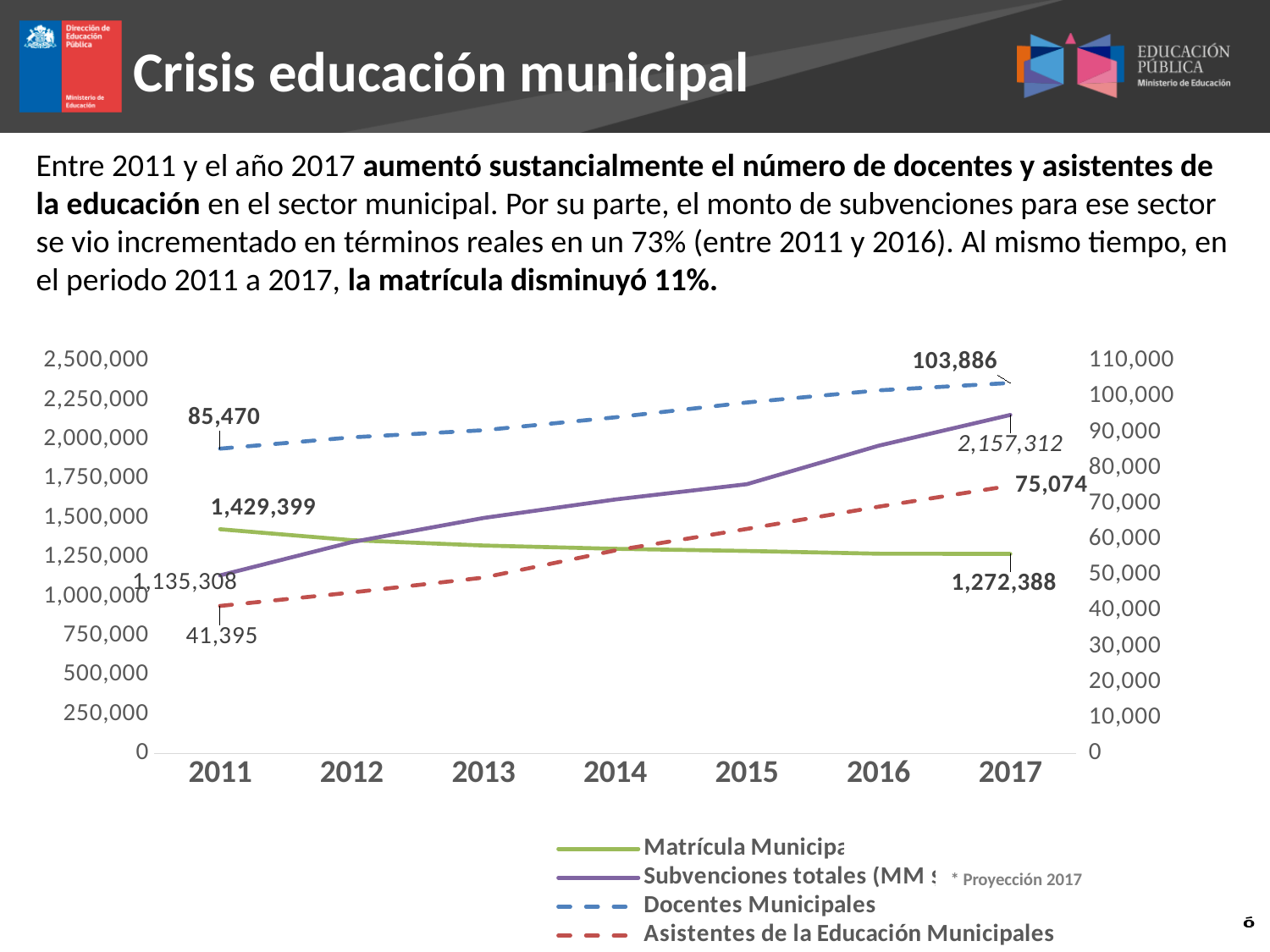
What is the value of Docentes Municipales in 2011? 85,470 By how much did Docentes Municipales increase from 2011 to 2017? 18,416 What is the value of Matrícula Municipal in 2017? 1,272,388 By how much did Matrícula Municipal decrease from 2011 to 2017? 157,011 How many years are shown on the x axis of the chart? 7 What is the value of Asistentes de la Educación Municipales in 2017? 75,074 What kind of chart is shown on the slide? line chart How many series does the chart legend list? 4 What is the value of Subvenciones totales (MM $) in 2017? 2,157,312 Does the Matrícula Municipal line rise or fall from 2011 to 2017? fall What is the value of Docentes Municipales in 2017? 103,886 What is the value of Matrícula Municipal in 2011? 1,429,399